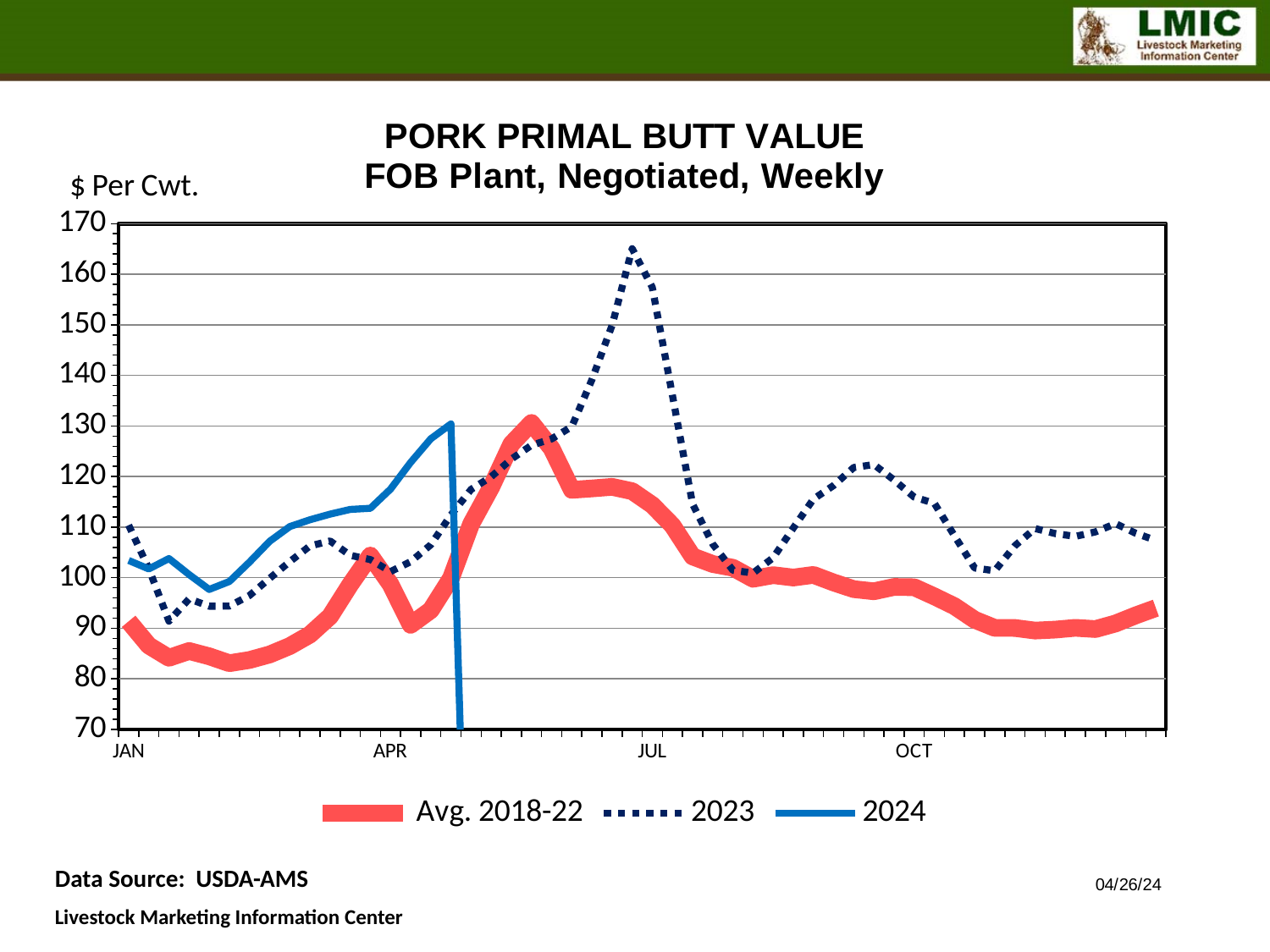
Does the 2024 series generally rise or fall from JAN to its last plotted point in April? rise Is the peak value of the 2023 series around JUL greater or less than 160? greater Which series reaches the highest value anywhere on the chart? 2023 Is the value of the 2024 series at APR greater or less than 110? greater What unit label is shown on the vertical axis? $ Per Cwt. Is the value of the Avg. 2018-22 series at JUL greater or less than 110? greater What kind of chart is shown on the slide? line chart Does the Avg. 2018-22 series rise or fall between JUL and OCT? fall At JAN, which series is higher: 2024 or Avg. 2018-22? 2024 How many series does the legend list? 3 What is the title of the chart? PORK PRIMAL BUTT VALUE FOB Plant, Negotiated, Weekly